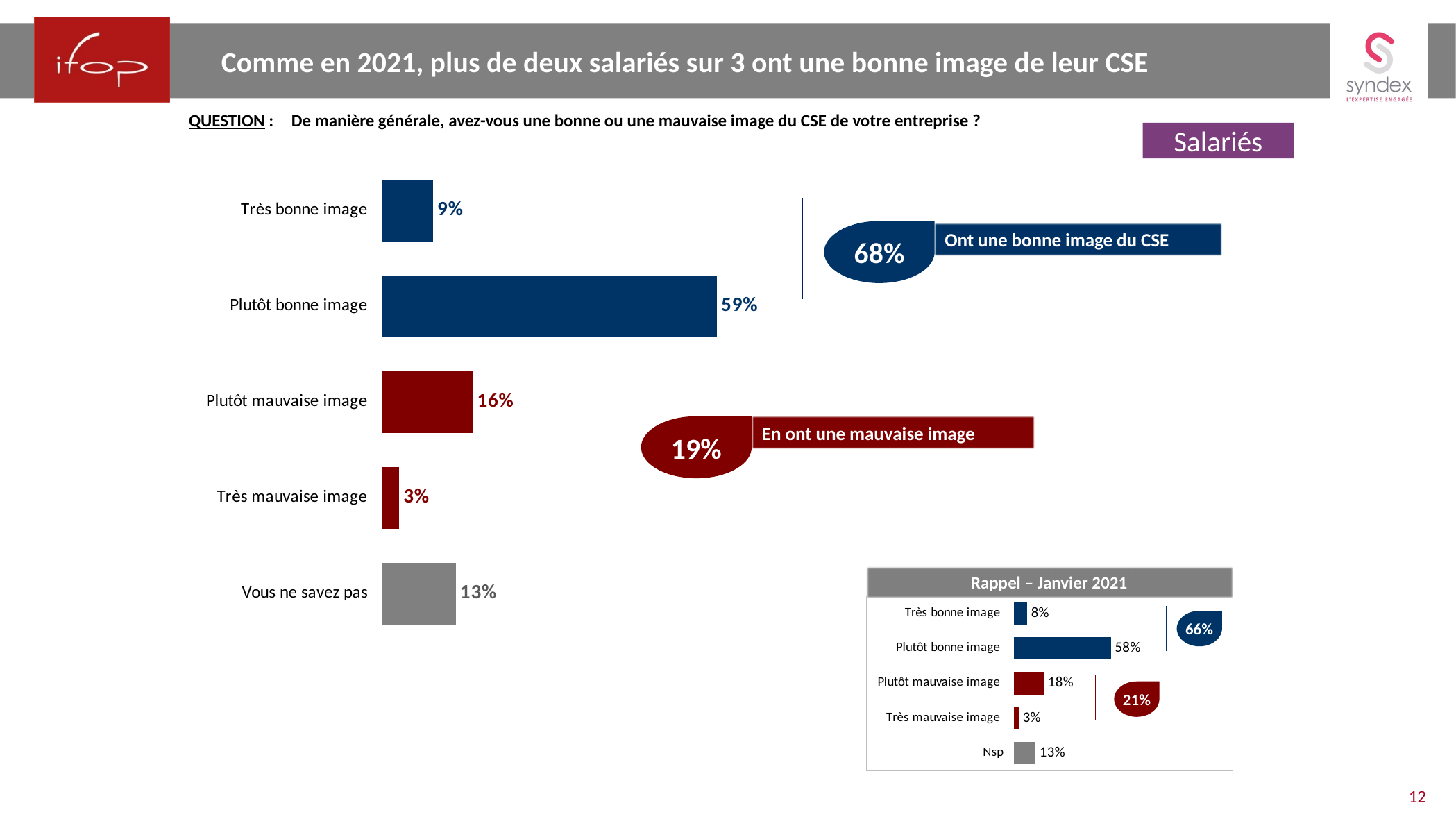
In the "Rappel – Janvier 2021" chart, what is the value for "Plutôt bonne image"? 58% In the main bar chart, what percentage is shown in the callout for those who have a good image of the CSE ("Ont une bonne image du CSE")? 68% In the main bar chart, what is the value for "Très mauvaise image"? 3% In the main bar chart, what is the difference between "Plutôt mauvaise image" and "Très bonne image"? 7 percentage points What kind of chart is the main chart on the slide? Bar chart In the main bar chart, what is the value for "Vous ne savez pas"? 13% In the main bar chart, which category has the highest value? Plutôt bonne image In the main bar chart, what is the value for "Plutôt bonne image"? 59% In the "Rappel – Janvier 2021" chart, what is the value for "Plutôt mauvaise image"? 18% How many categories does the main bar chart show? 5 In the main bar chart, which category has the lowest value? Très mauvaise image In the main bar chart, which is larger: "Plutôt mauvaise image" or "Vous ne savez pas"? Plutôt mauvaise image